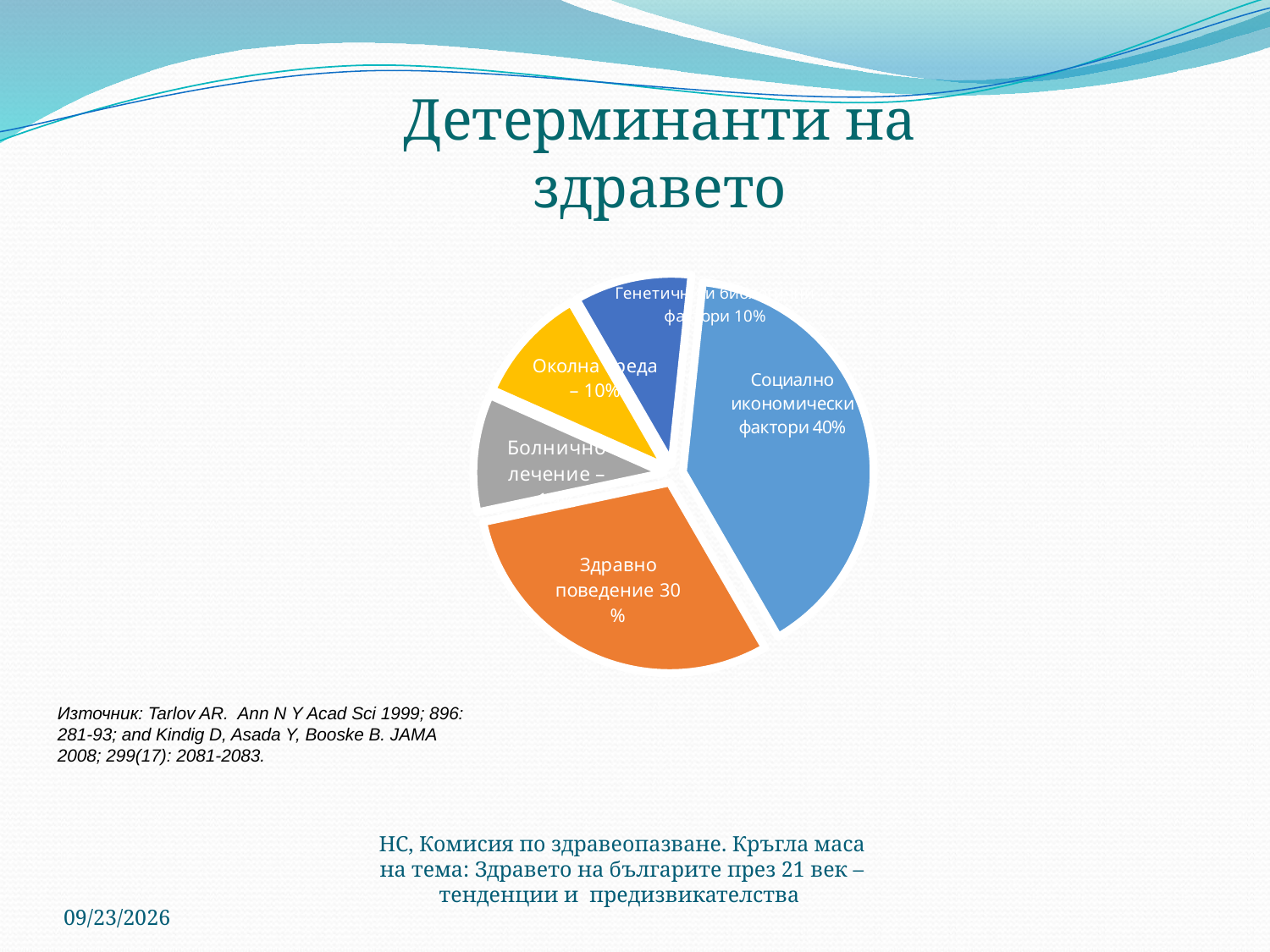
How many slices does the pie chart have? 5 What kind of chart is shown on the slide? pie chart What colour is the slice for Здравно поведение? orange Which is larger: the slice for Социално икономически фактори or the slice for Здравно поведение? Социално икономически фактори Which category has the largest slice of the pie chart? Социално икономически фактори What share of the pie is labelled for Околна среда? 10% Which is larger: the slice for Здравно поведение or the slice for Околна среда? Здравно поведение What is the difference between the shares of Социално икономически фактори and Здравно поведение? 10% What share of the pie is labelled for Социално икономически фактори? 40% What share of the pie is labelled for Здравно поведение? 30% What is the title of the slide containing the pie chart? Детерминанти на здравето